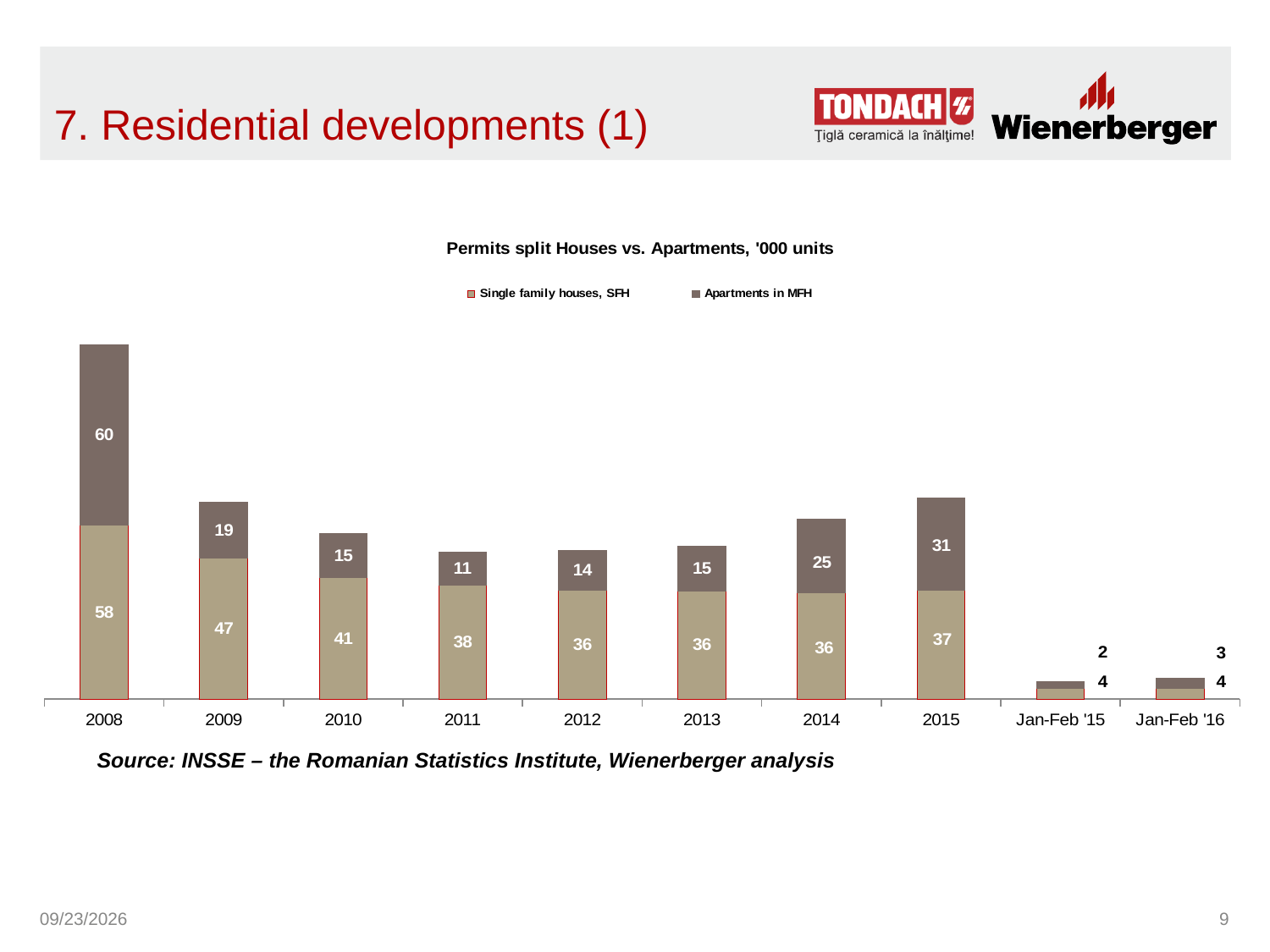
What type of chart is shown on the slide? Stacked bar chart What is the total of the stacked bar for 2014? 61 Which year has the highest value for Apartments in MFH? 2008 What is the value for Apartments in MFH in Jan-Feb '16? 3 What is the title of the chart? Permits split Houses vs. Apartments, '000 units Which is larger, the Apartments in MFH value for 2014 or for 2013? 2014 What is the value for Single family houses, SFH in 2008? 58 How many categories are shown on the x axis? 10 What is the value for Apartments in MFH in 2015? 31 How many series does the legend list? 2 What is the difference between the Single family houses, SFH values for 2008 and 2009? 11 Which year between 2008 and 2015 has the lowest value for Apartments in MFH? 2011